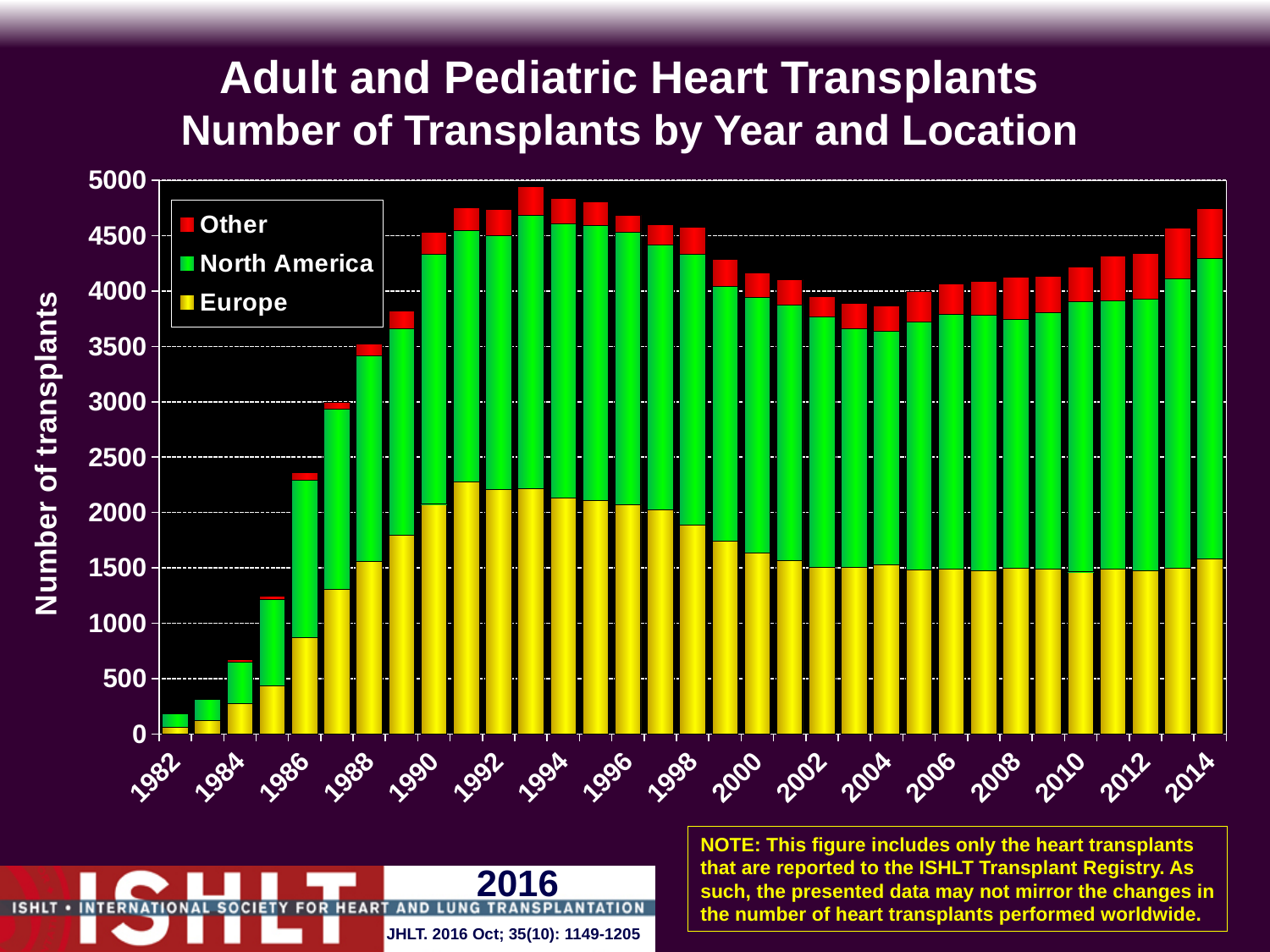
Which year has the tallest bar (highest total number of transplants)? 1993 What kind of chart is shown on the slide? Stacked bar chart How many years (bars) are plotted on the chart? 33 Is the total number of transplants in 2004 greater or less than 4000? less Is the total number of transplants in 1982 greater or less than 500? less Is the total number of transplants in 1993 greater or less than 4500? greater What is the title of the vertical axis? Number of transplants Which year has a higher total number of transplants, 1990 or 2000? 1990 How many series does the legend list? 3 Do the total number of transplants rise or fall from 1982 to 1993? rise Which year has the shortest bar (lowest total number of transplants)? 1982